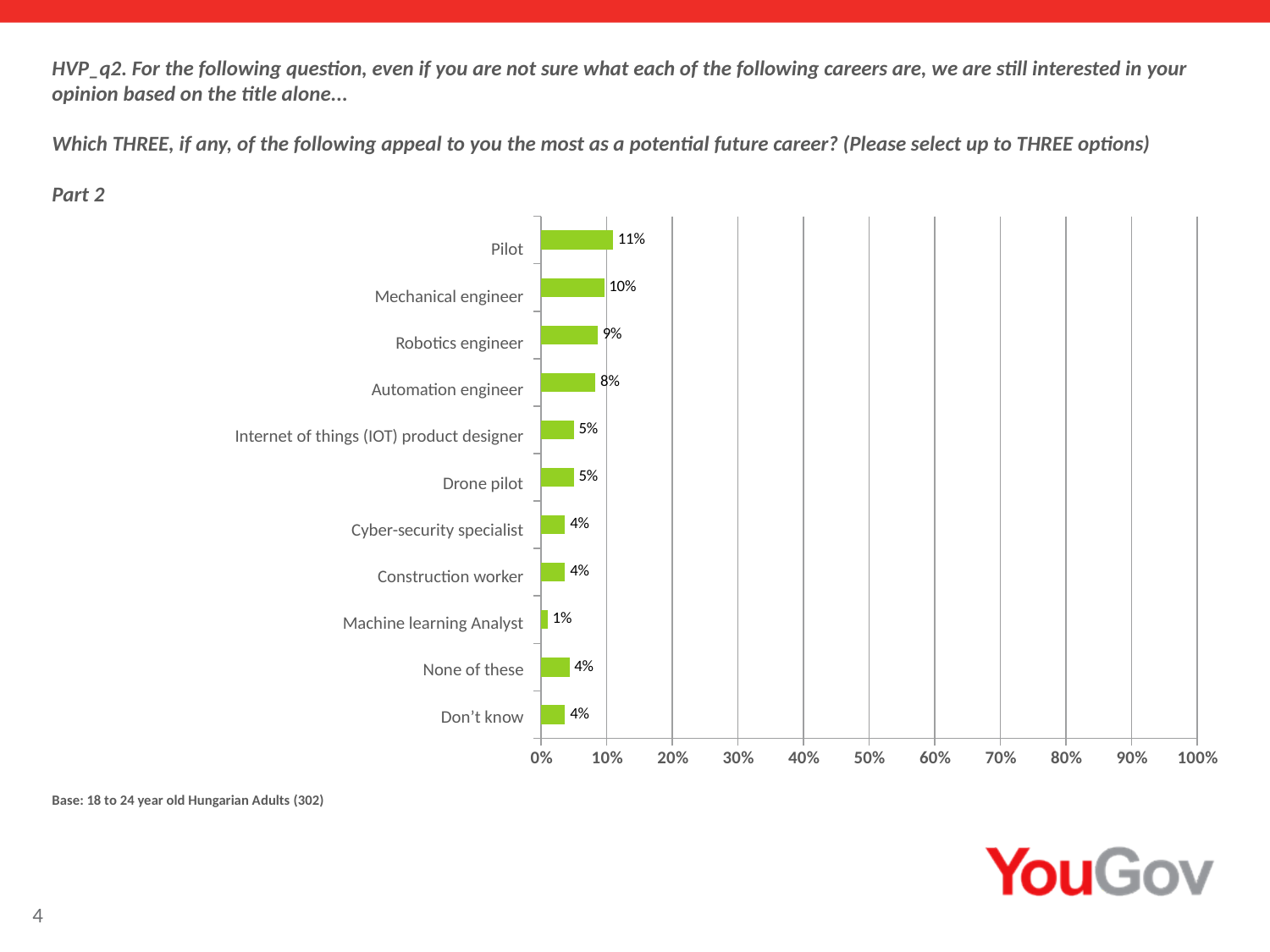
What percentage is shown for Machine learning Analyst? 1% Which has a higher value, Mechanical engineer or Drone pilot? Mechanical engineer How many categories are shown on the chart? 11 What colour are the bars in the chart? Green What kind of chart is shown on the slide? Bar chart What is the value shown for Internet of things (IOT) product designer? 5% Which category has the lowest percentage on the chart? Machine learning Analyst What is the value shown for Automation engineer? 8% What is the difference in percentage points between Pilot and Robotics engineer? 2 What percentage of respondents selected Pilot as an appealing future career? 11% Which career option has the highest percentage on the chart? Pilot Is the value for Pilot greater or less than 10%? greater